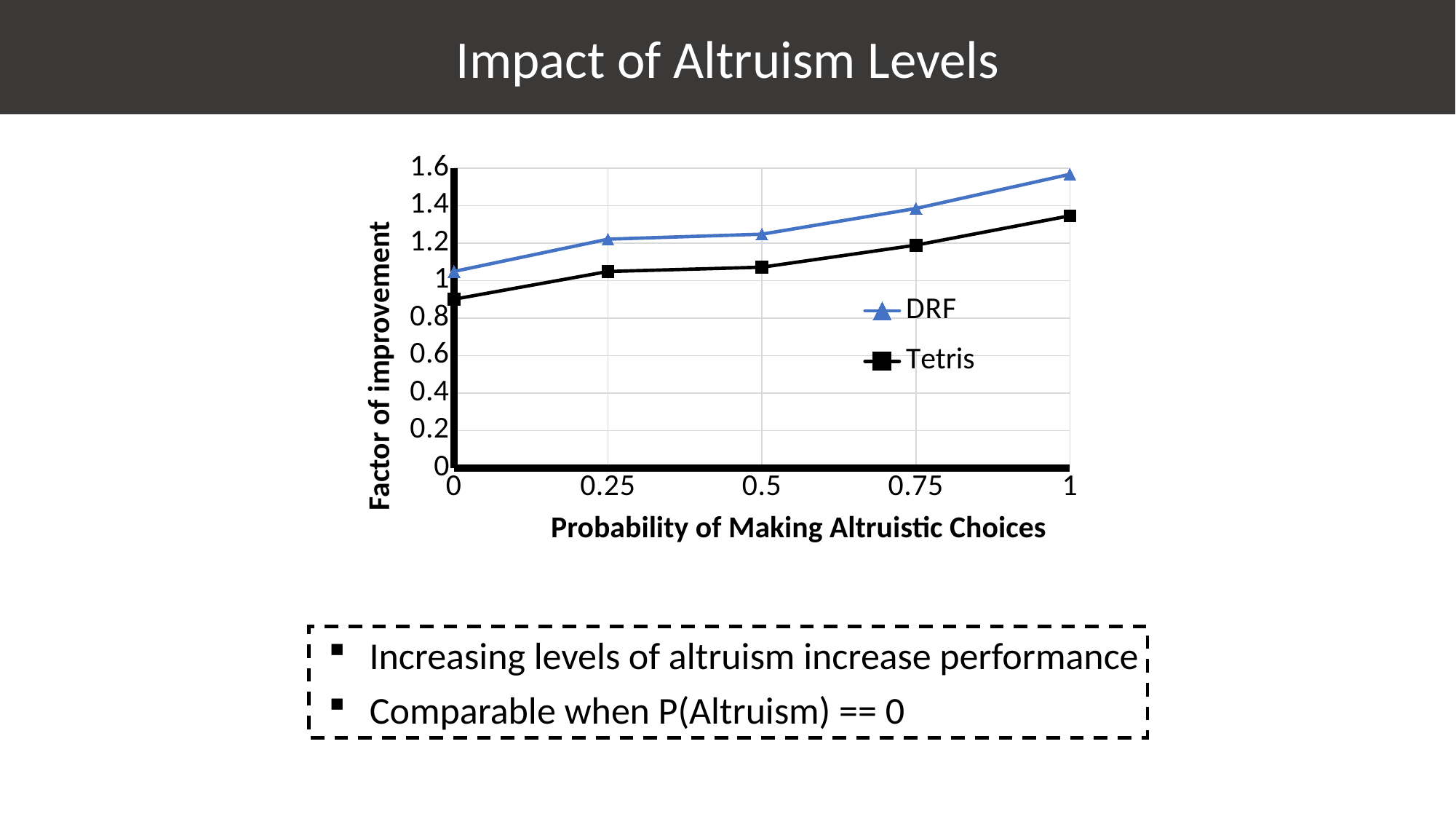
At which probability of making altruistic choices is the DRF factor of improvement highest? 1 Do the Tetris values rise or fall along the x axis? rise How many series does the legend list? 2 At probability 1, which series has the larger factor of improvement, DRF or Tetris? DRF What is the label of the y axis? Factor of improvement Is the DRF value at probability 1 greater or less than 1.4? greater What kind of chart is shown on the slide? line chart Is the Tetris value at probability 0 greater or less than 1? less Is the Tetris value at probability 1 greater or less than 1.2? greater Do the DRF values rise or fall as the probability of making altruistic choices increases? rise At which probability of making altruistic choices is the Tetris factor of improvement lowest? 0 How many x-axis points are plotted for each series? 5